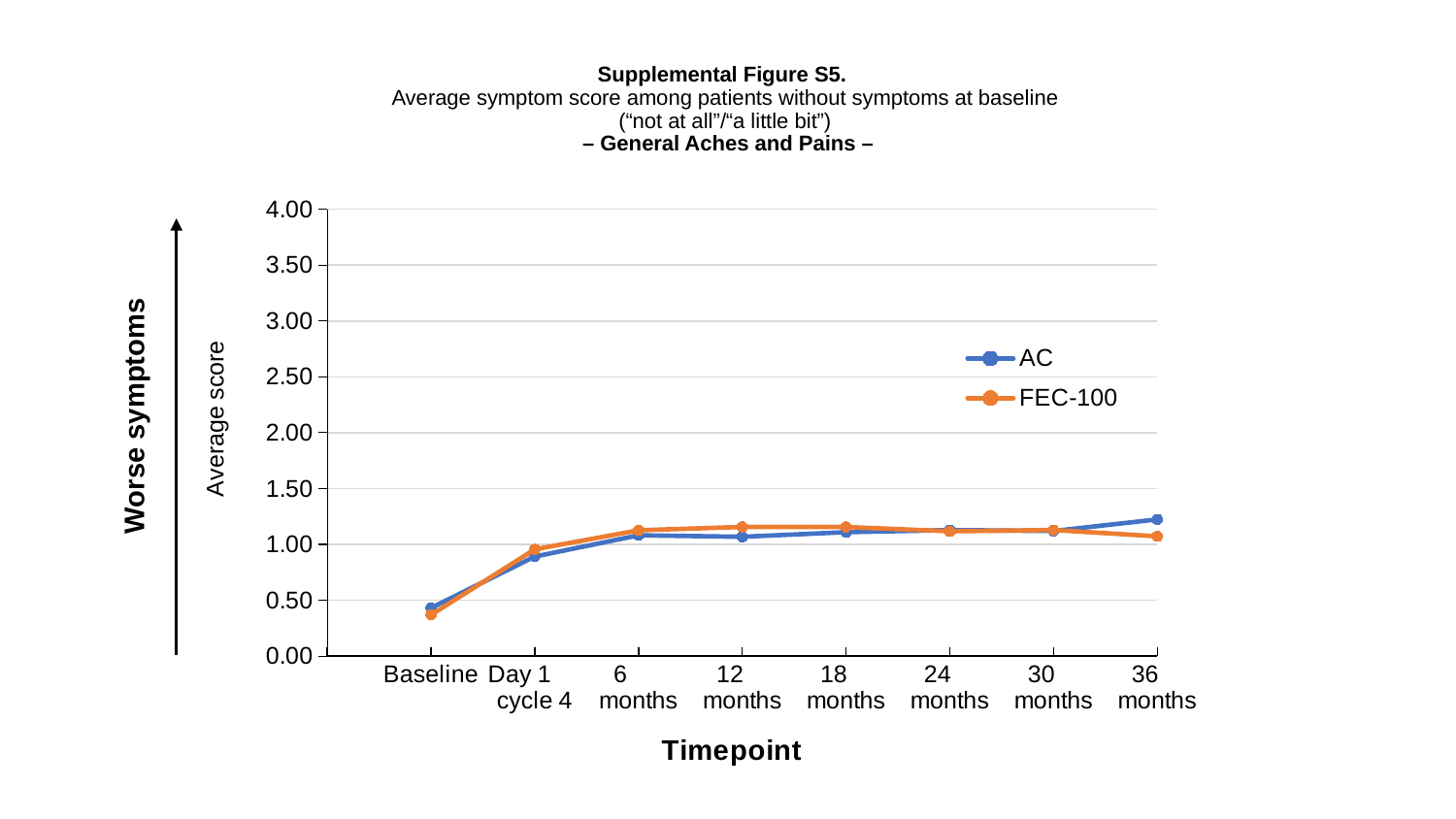
How many series does the legend list? 2 How many timepoints are plotted along the x axis? 8 At which timepoint is the AC series highest? 36 months What is the label of the x axis? Timepoint Is the FEC-100 value at Baseline greater or less than 0.50? less Is the AC value at Baseline greater or less than 0.50? less Is the AC value at Day 1 cycle 4 greater or less than 1.00? less At 36 months, which series has the larger value, AC or FEC-100? AC At which timepoint is the FEC-100 series lowest? Baseline What kind of chart is shown on the slide? line chart Do the values rise or fall from Baseline to 6 months? rise